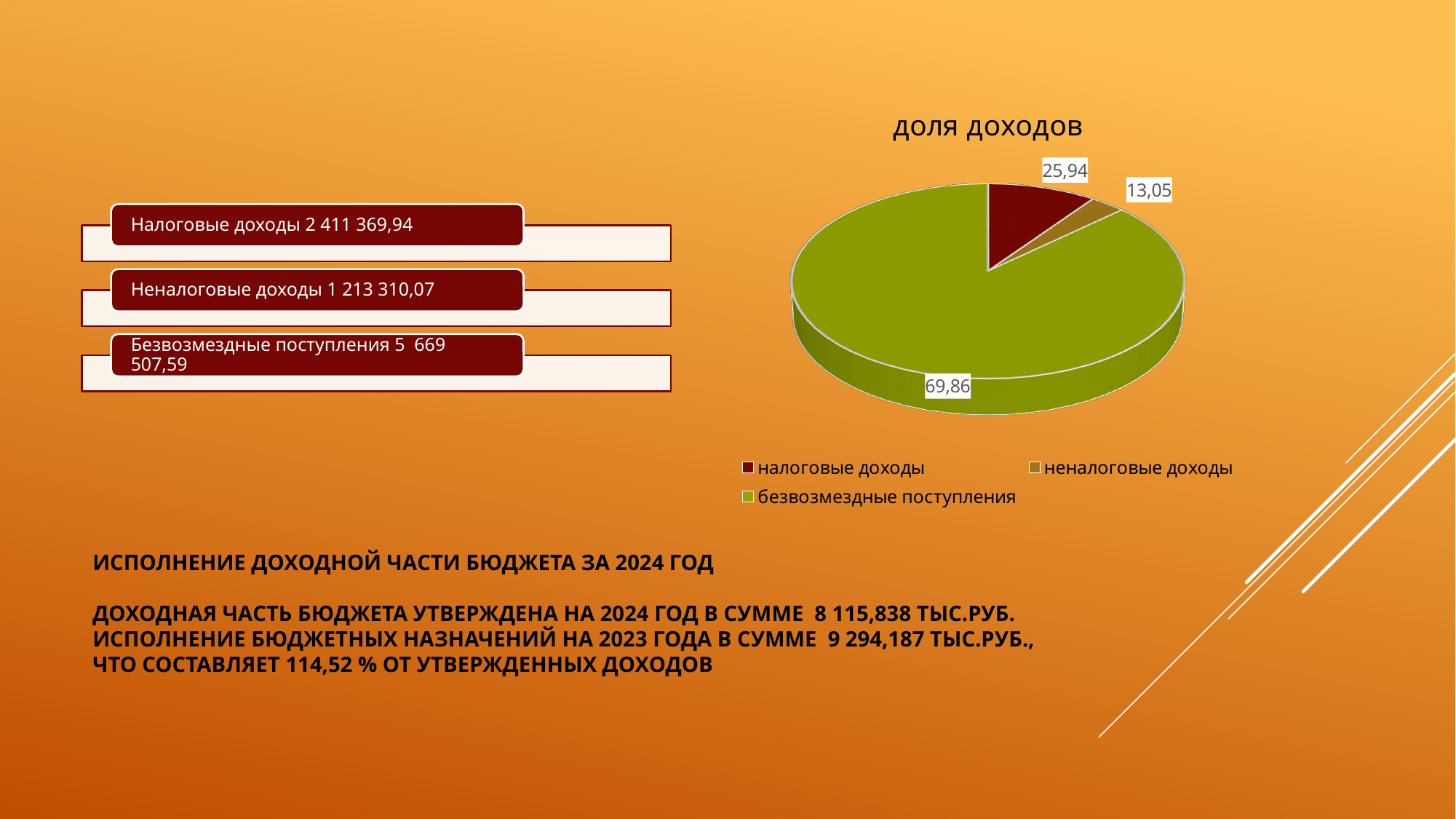
Which category has the smallest slice in the pie chart? неналоговые доходы What is the difference between the values for безвозмездные поступления and налоговые доходы in the pie chart? 43,92 Which is larger in the pie chart: налоговые доходы or неналоговые доходы? налоговые доходы How many entries does the legend of the pie chart list? 3 What type of chart is shown on the slide? pie chart What value is shown for налоговые доходы in the pie chart? 25,94 What value is shown for безвозмездные поступления in the pie chart? 69,86 How many slices does the pie chart have? 3 Which category has the largest slice in the pie chart? безвозмездные поступления What is the title of the pie chart? доля доходов What value is shown for неналоговые доходы in the pie chart? 13,05 What is the difference between the values for налоговые доходы and неналоговые доходы in the pie chart? 12,89